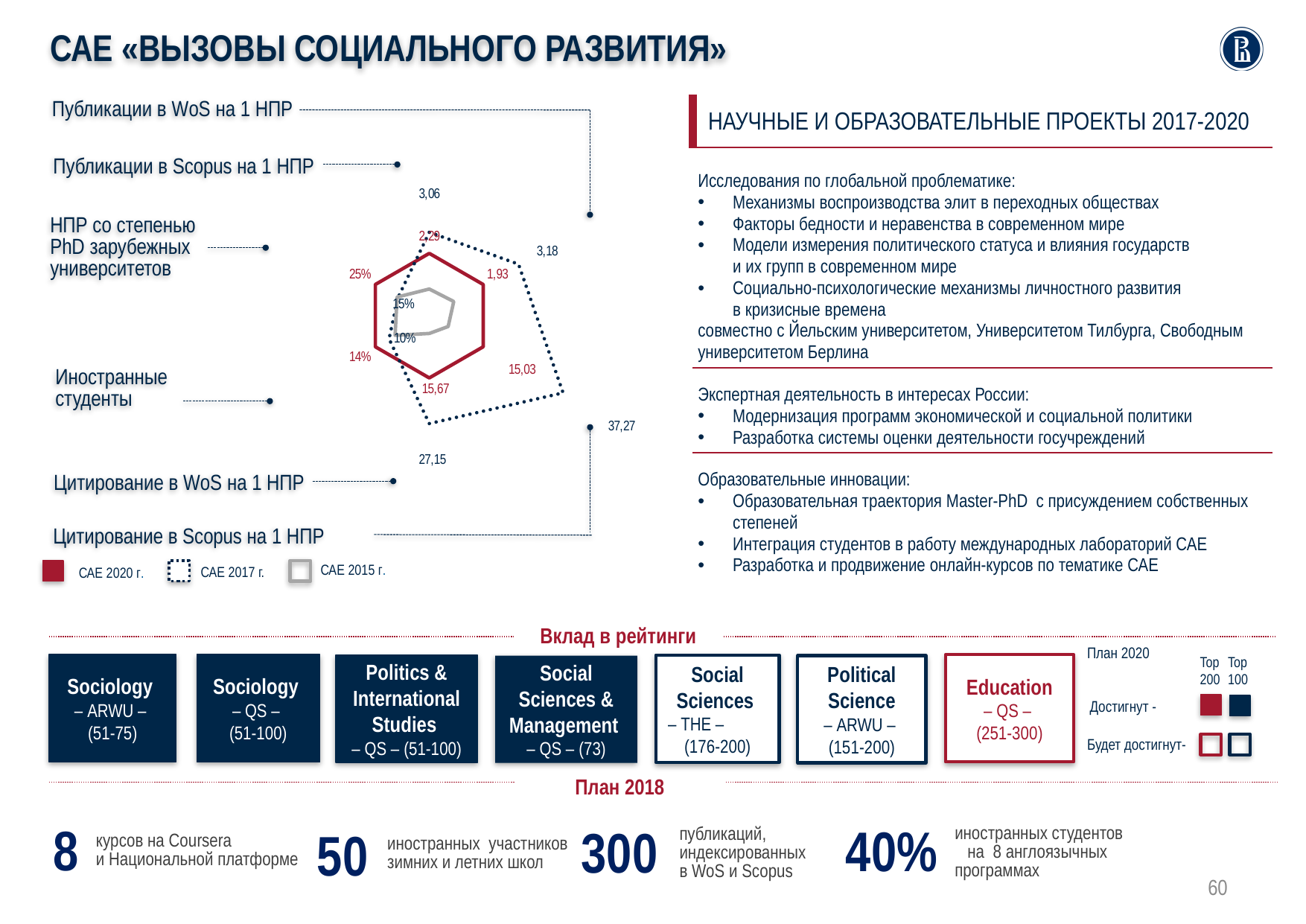
For Цитирование в Scopus на 1 НПР, which series has the larger value: САЕ 2017 г. or САЕ 2020 г.? САЕ 2017 г. What kind of chart is shown on the left of the slide? Radar chart By how many percentage points does the 2020 value for НПР со степенью PhD зарубежных университетов exceed the 2015 value? 10 percentage points What is the value for НПР со степенью PhD зарубежных университетов for САЕ 2020 г.? 25% How many axes (indicators) does the radar chart have? 6 What colour is used for the САЕ 2020 г. series on the radar chart? Red What is the value for Цитирование в WoS на 1 НПР for САЕ 2017 г.? 27,15 Which years are listed in the legend of the radar chart? САЕ 2020 г., САЕ 2017 г., САЕ 2015 г. What is the value for НПР со степенью PhD зарубежных университетов for САЕ 2015 г.? 15% What is the value for Иностранные студенты for САЕ 2020 г. on the radar chart? 14% How many series does the legend of the radar chart list? 3 What is the value for Иностранные студенты for САЕ 2015 г. on the radar chart? 10%